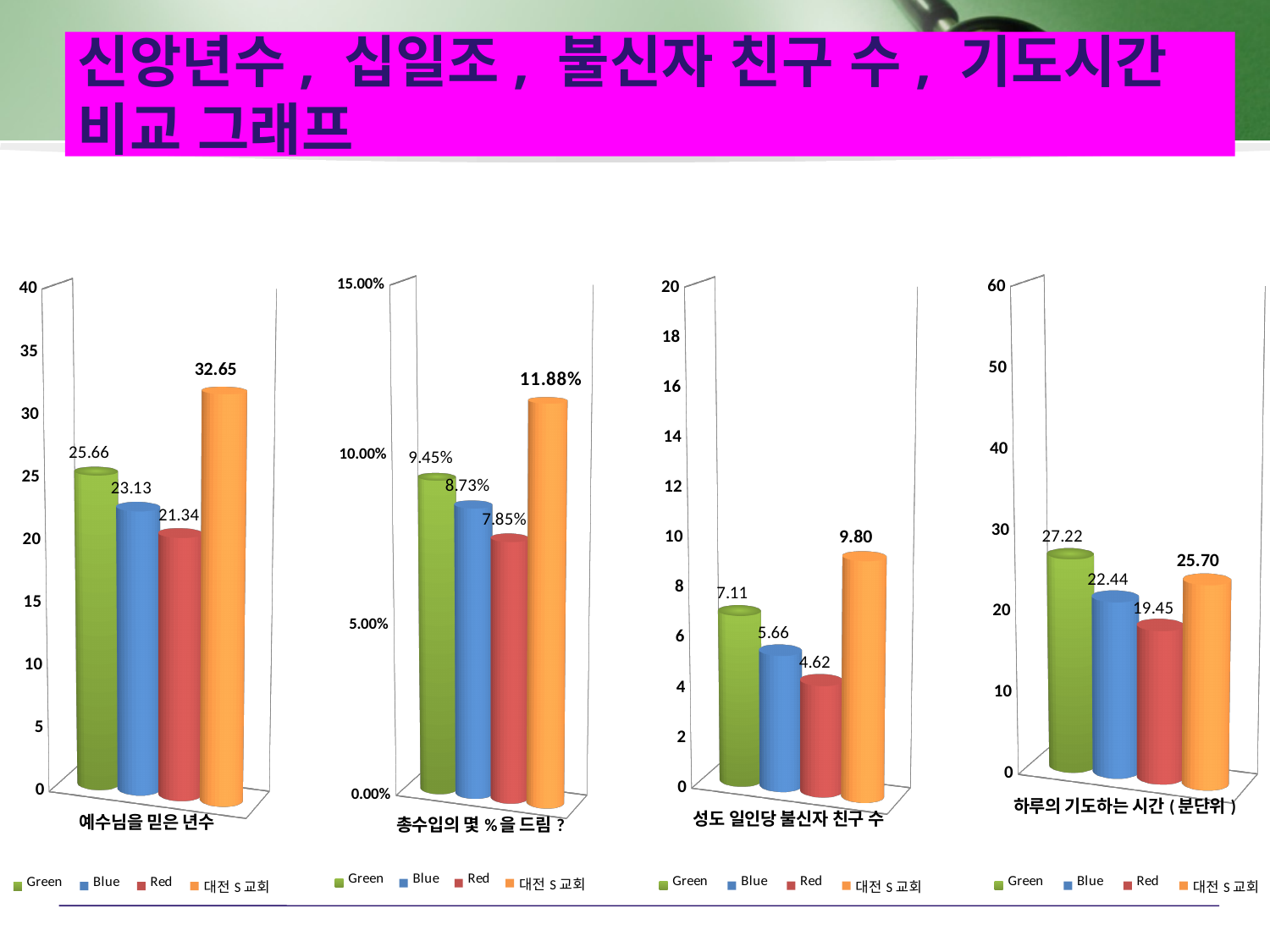
In the chart titled 성도 일인당 불신자 친구 수, what is the value for Red? 4.62 In the chart titled 예수님을 믿은 년수, what is the difference between the Green value and the Blue value? 2.53 How many series does the legend of the chart titled 예수님을 믿은 년수 list? 4 In the chart titled 성도 일인당 불신자 친구 수, which is larger, the Green value or the Blue value? Green In the chart titled 하루의 기도하는 시간 (분단위), what is the difference between the 대전 S 교회 value and the Red value? 6.25 In the chart titled 총수입의 몇 %을 드림?, what is the value for Blue? 8.73% In the chart titled 총수입의 몇 %을 드림?, is the value for Red greater or less than 10.00%? less In the chart titled 하루의 기도하는 시간 (분단위), what is the value for Green? 27.22 In the chart titled 예수님을 믿은 년수, what is the value for 대전 S 교회? 32.65 In the chart titled 예수님을 믿은 년수, which series has the lowest value? Red In the chart titled 총수입의 몇 %을 드림?, which series has the highest value? 대전 S 교회 In the chart titled 하루의 기도하는 시간 (분단위), which series has the highest value? Green